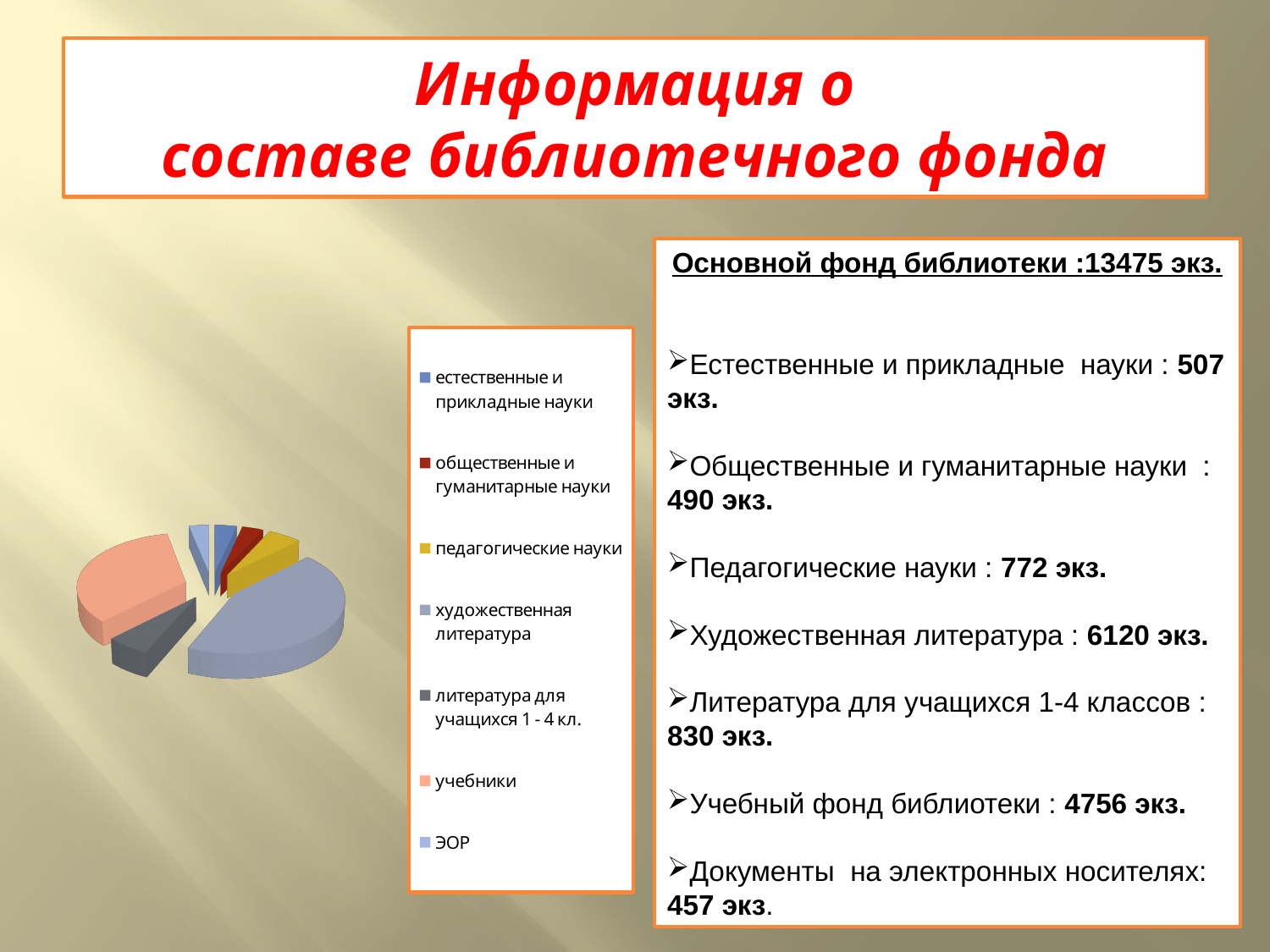
Which slice is larger in the pie chart: художественная литература or литература для учащихся 1 - 4 кл.? художественная литература Which slice is larger in the pie chart: художественная литература or учебники? художественная литература Which slice is larger in the pie chart: учебники or педагогические науки? учебники What is the last entry listed in the pie chart's legend? ЭОР What kind of chart is shown on the slide? pie chart What colour is the slice for педагогические науки in the pie chart? yellow How many categories does the legend of the pie chart list? 7 Which category has the largest slice in the pie chart? художественная литература